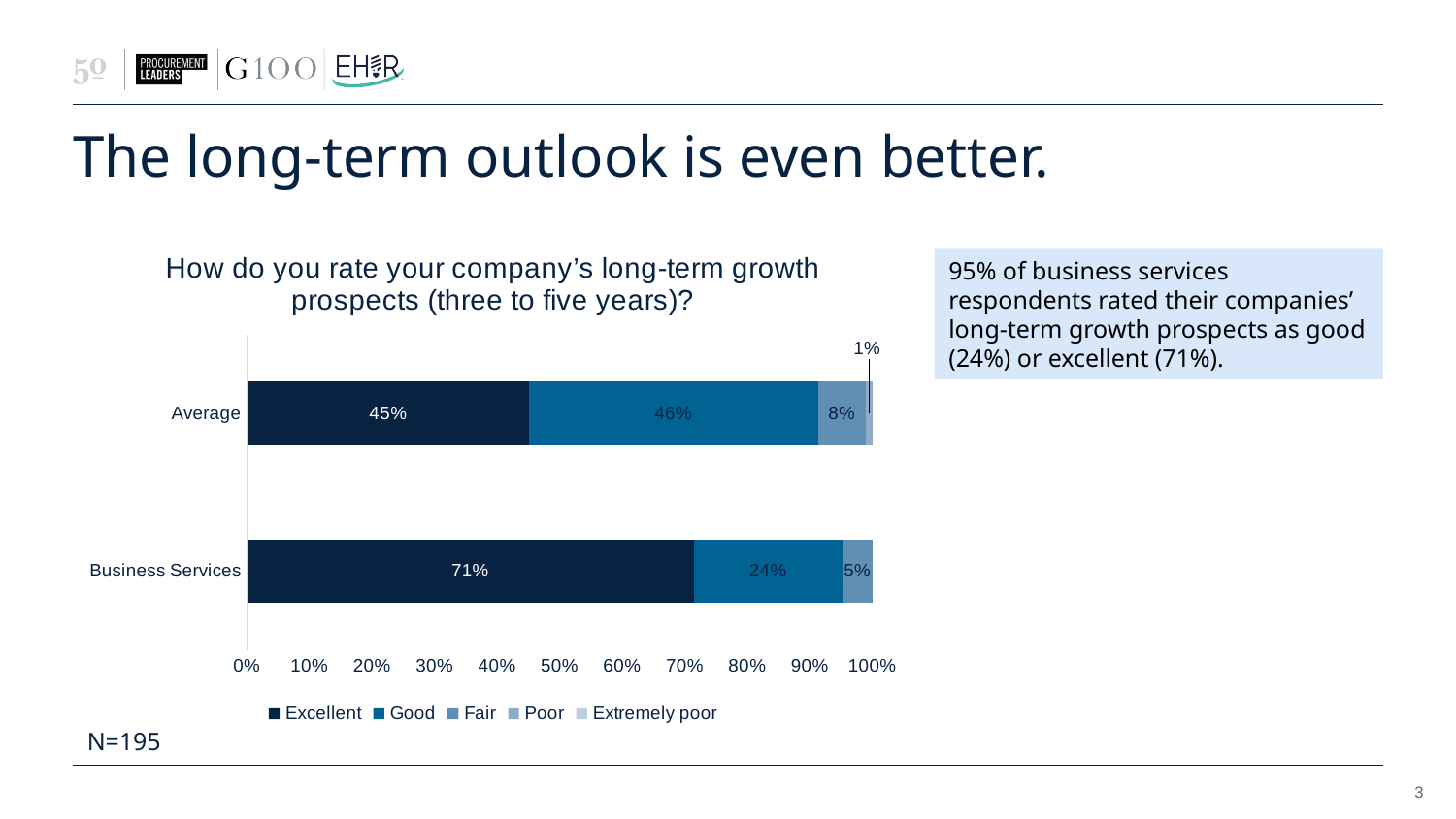
What percentage of Business Services respondents rated their long-term growth prospects as Excellent? 71% How many categories are shown on the y axis of the chart? 2 What kind of chart is shown on the slide? Stacked bar chart What is the Good value for the Average category? 46% What is the difference between the Excellent share for Business Services and the Excellent share for Average? 26% What is the Good value for Business Services? 24% What percentage of Average respondents rated their long-term growth prospects as Excellent? 45% What is the combined Excellent and Good share for Business Services? 95% What is the Fair value for the Average category? 8% What is the Fair value for Business Services? 5% How many series does the chart legend list? 5 Which category has the higher Excellent share, Average or Business Services? Business Services